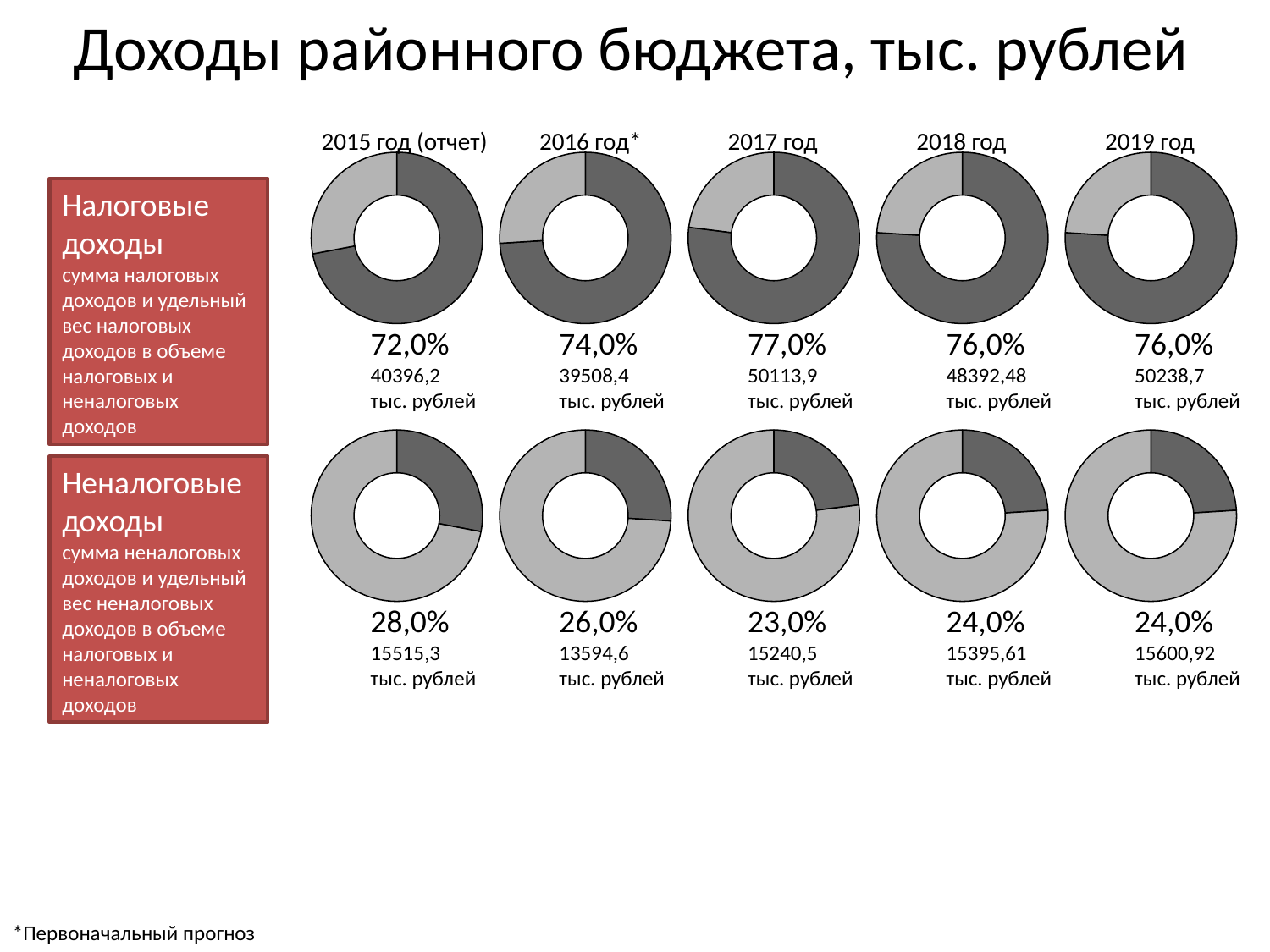
Do the Неналоговые доходы percentages rise or fall from 2015 год to 2017 год? fall In the Налоговые доходы chart for 2017 год, what share of income is shown? 77,0% What kind of chart is used on this slide? pie (donut) chart Which is larger: the Налоговые доходы amount for 2019 год or for 2017 год? 2019 год Across the Налоговые доходы charts, which year shows the highest percentage? 2017 год Across the Неналоговые доходы charts, which year shows the lowest percentage? 2017 год How many donut charts are shown on the slide? 10 In the Неналоговые доходы chart for 2019 год, what percentage is shown? 24,0% Across the Налоговые доходы charts, which year has the lowest amount in тыс. рублей? 2016 год Which year label on the slide is marked with an asterisk (Первоначальный прогноз)? 2016 год What is the difference between the Налоговые доходы percentage for 2017 год and for 2015 год? 5,0% In the Неналоговые доходы chart for 2016 год, what amount is printed below the chart? 13594,6 тыс. рублей